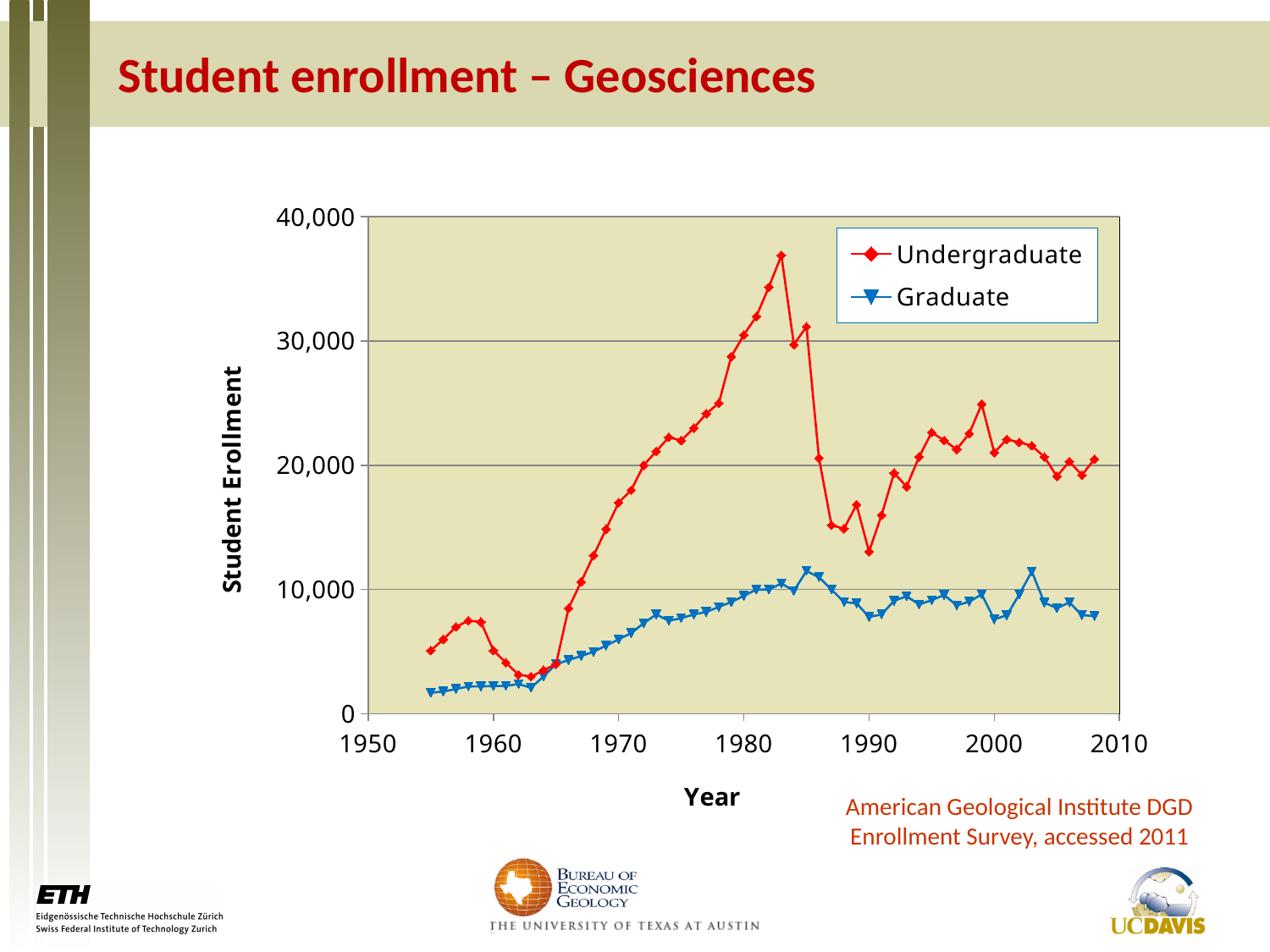
In 1980, which series has the larger value, Undergraduate or Graduate? Undergraduate What is the label on the x axis of the chart? Year Is the Graduate value in 1955 greater or less than 10,000? less How many series does the legend list? 2 Which series reaches the highest value on the chart? Undergraduate Is the Undergraduate value in 1970 greater or less than 20,000? less What are the two series named in the legend? Undergraduate and Graduate What kind of chart is shown on the slide? line chart Does the Undergraduate series rise or fall between 1983 and 1990? fall Is the Undergraduate value in 1983 greater or less than 30,000? greater Does the Undergraduate series rise or fall between 1965 and 1983? rise